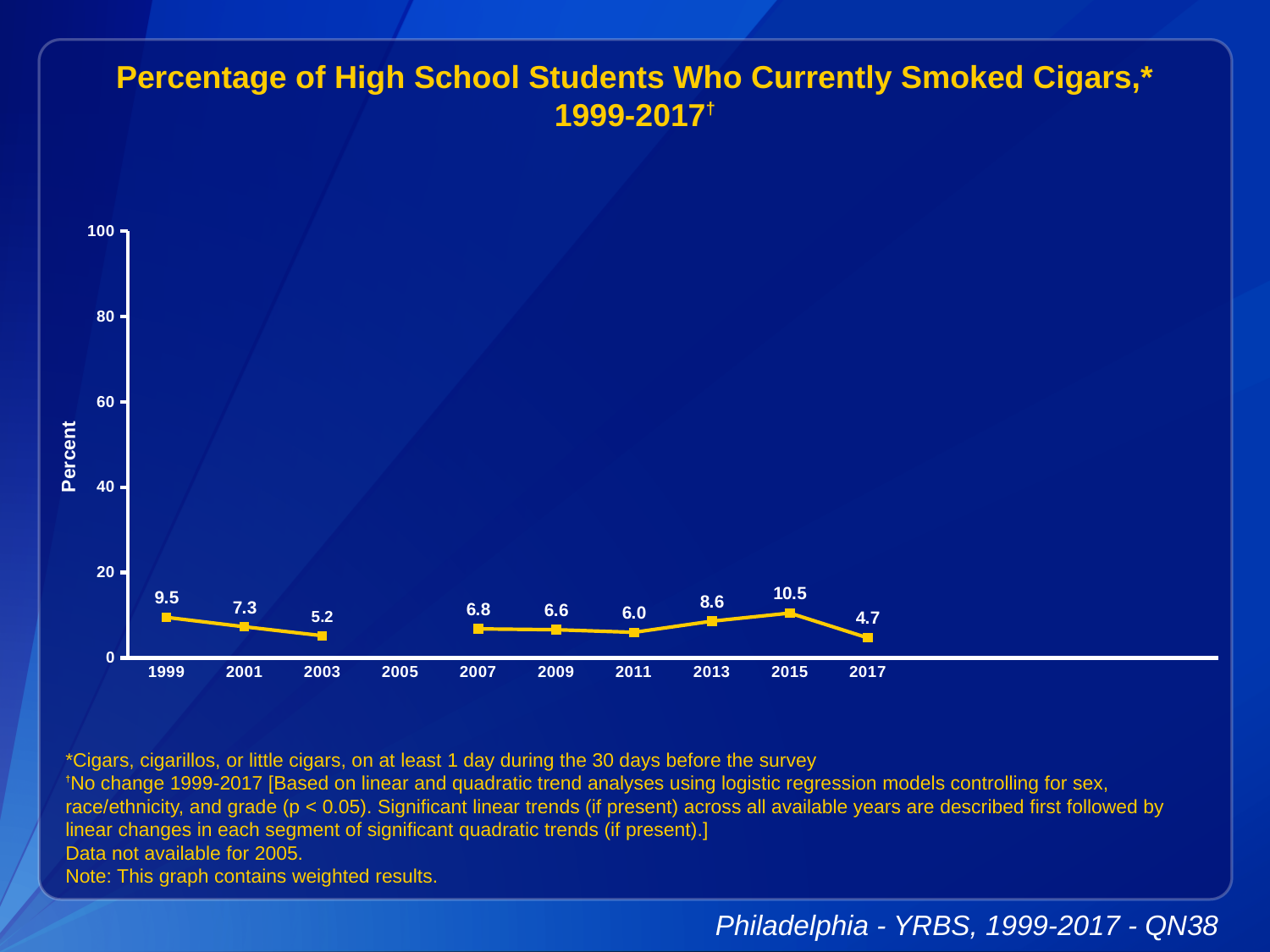
Which year has the lowest percentage? 2017 Which year has the highest percentage? 2015 How many years have data points plotted on the chart? 9 Is the value for 2015 greater or less than 20? less What is the difference between the values for 2015 and 2017? 5.8 What value is shown for 2015? 10.5 What kind of chart is shown on the slide? line chart What value is shown for 2017? 4.7 Did the percentage rise or fall from 1999 to 2003? fall Which year on the x axis has no data point plotted? 2005 Which year has a larger value, 2003 or 2013? 2013 What was the percentage of high school students who currently smoked cigars in 1999? 9.5